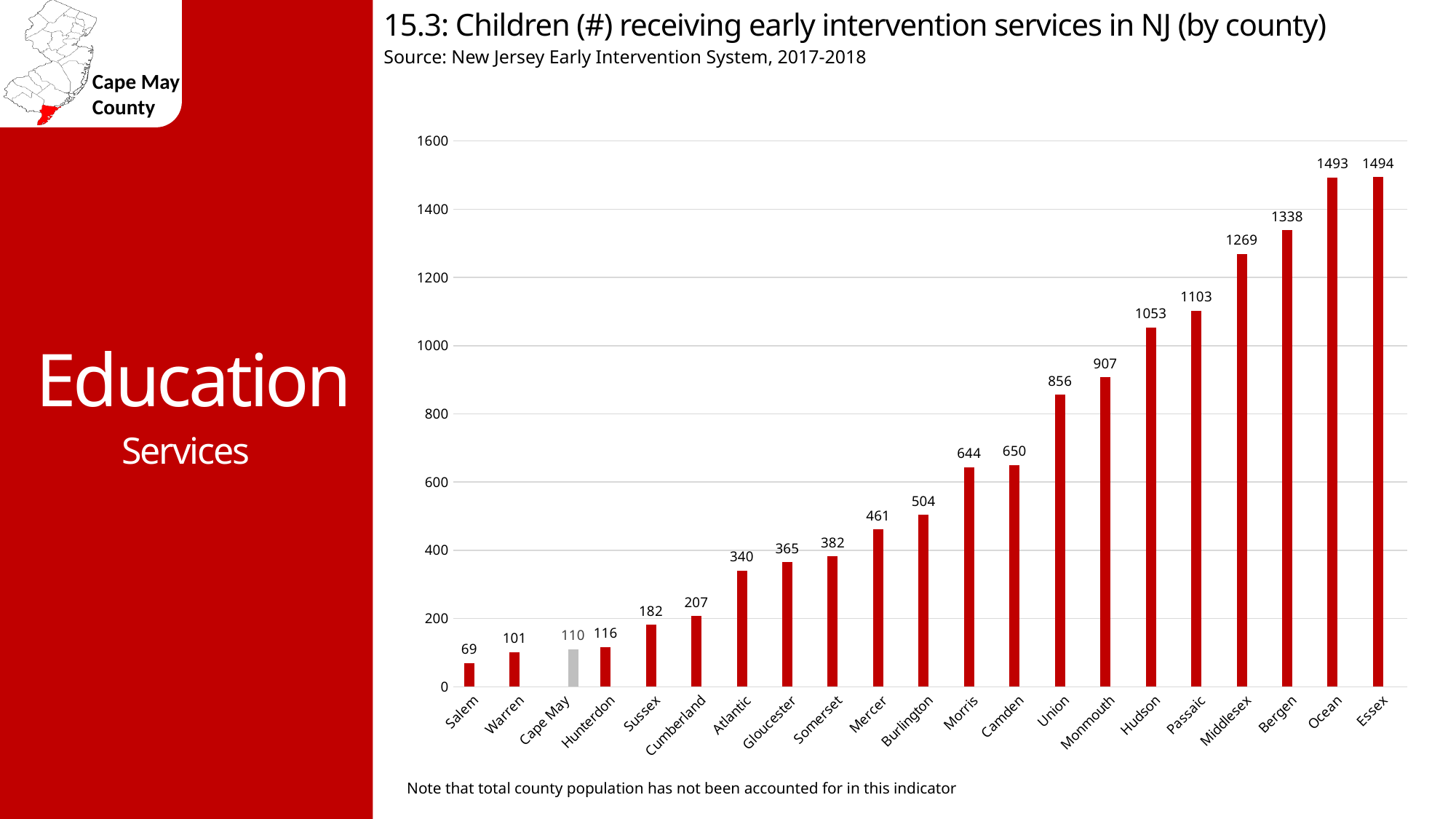
How many children received early intervention services in Cape May County? 110 Which county has a higher value, Union or Monmouth? Monmouth Do the values generally rise or fall moving from left to right along the x axis? Rise What is the difference between the values for Bergen and Middlesex? 69 Which county's bar is shown in grey rather than red? Cape May How many counties are shown on the chart? 21 What is the difference between the values for Hunterdon and Cape May? 6 What is the value shown for Hudson County? 1053 Is the value for Passaic greater or less than 1000? greater Which county has the lowest number of children receiving early intervention services? Salem What is the value shown for Essex County? 1494 What type of chart is used on this slide? Bar chart